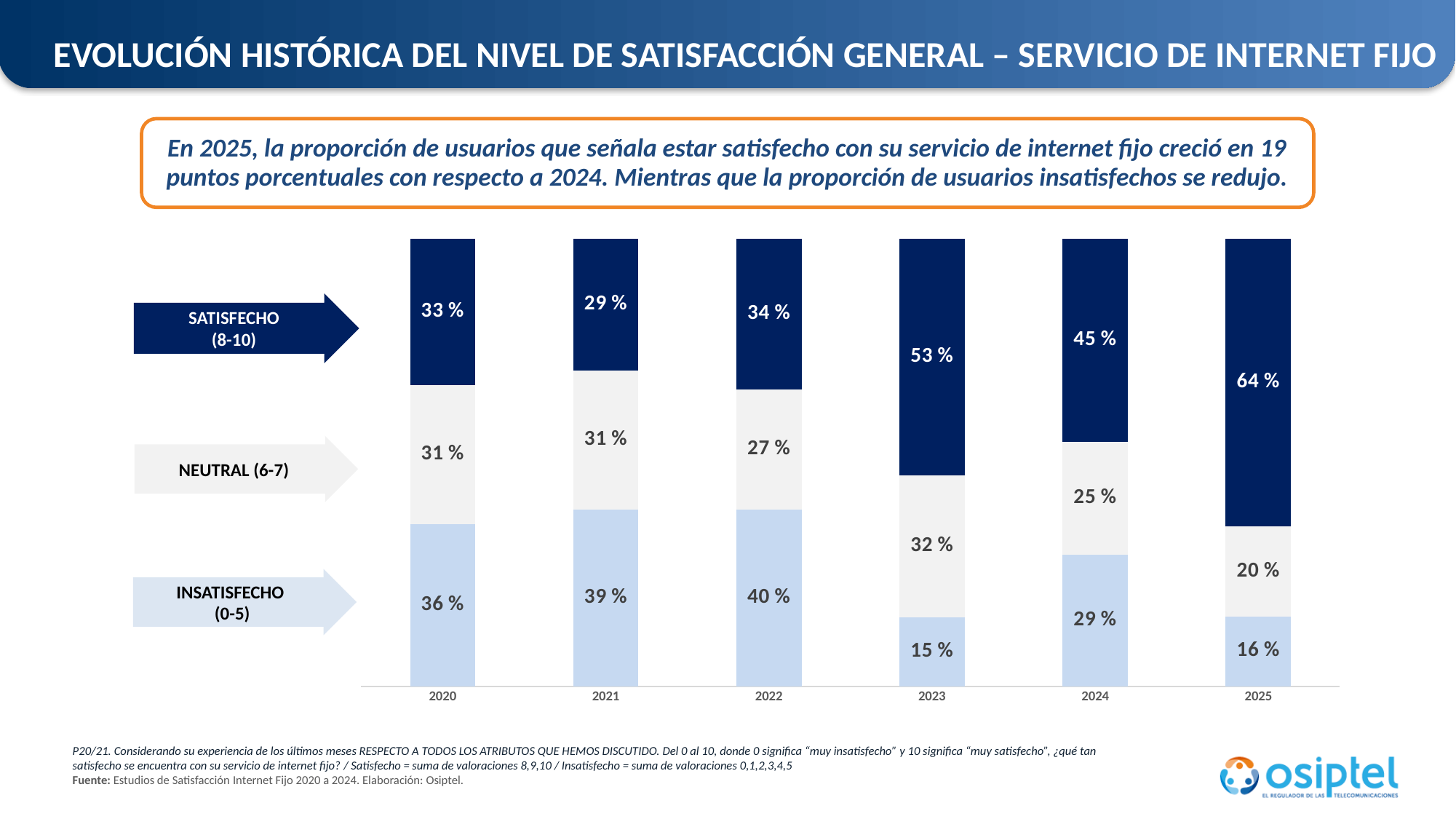
What is the difference between the Satisfecho (8-10) values for 2025 and 2024? 19 % Which series is shown in dark blue? Satisfecho (8-10) In which year is the Satisfecho (8-10) share highest? 2025 How many years are shown on the x axis? 6 Does the Neutral (6-7) share rise or fall from 2023 to 2025? Fall What is the Insatisfecho (0-5) value for 2022? 40 % What kind of chart is shown on the slide? Stacked bar chart What is the Satisfecho (8-10) value for 2025? 64 % In which year is the Insatisfecho (0-5) share lowest? 2023 How many series does the chart show? 3 What is the Neutral (6-7) value for 2023? 32 % Which is larger, the Insatisfecho (0-5) value for 2021 or for 2024? 2021